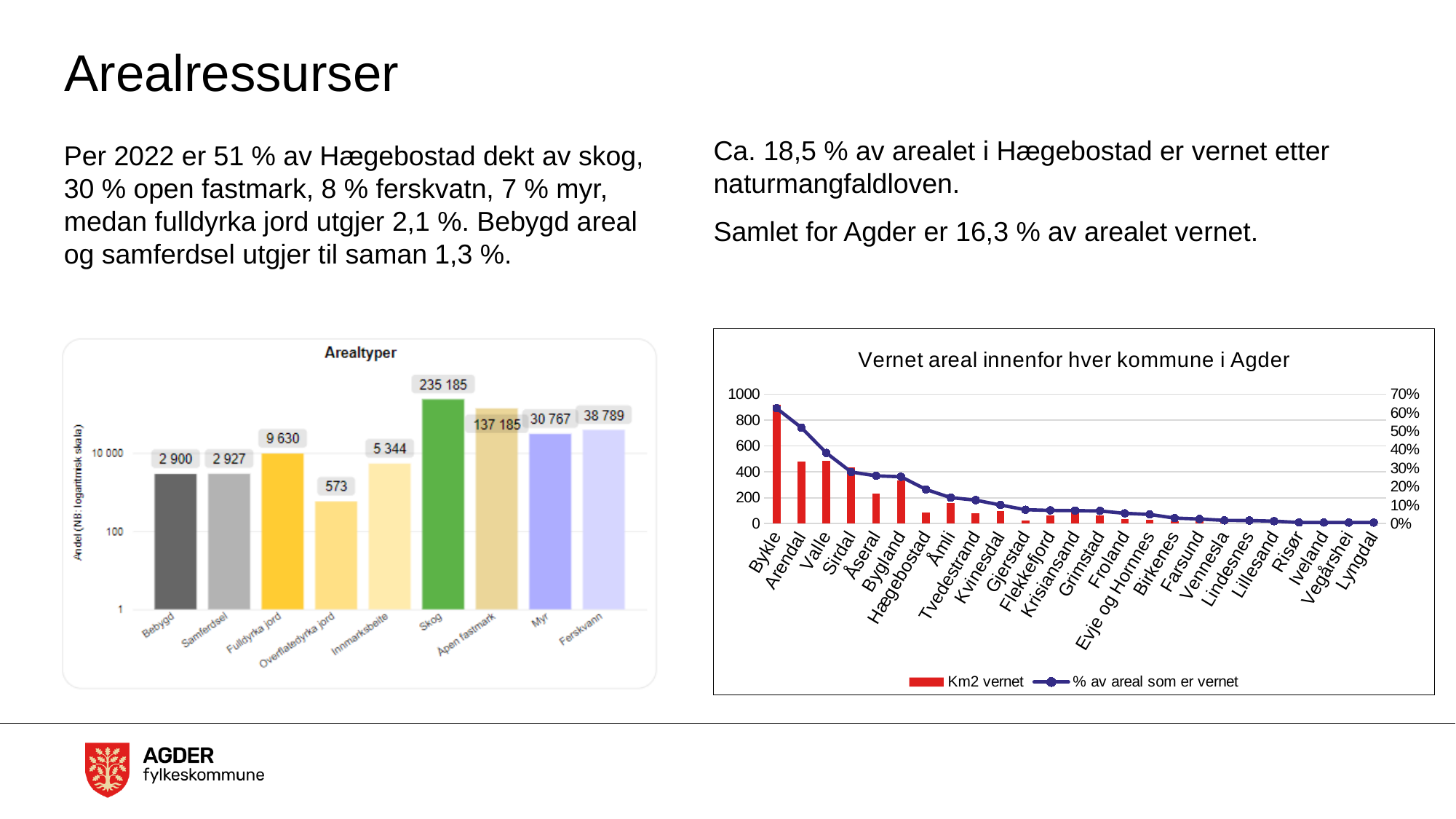
How many categories are shown in the Arealtyper chart? 9 In the chart 'Vernet areal innenfor hver kommune i Agder', is the Km2 vernet value for Arendal greater or less than 600? less In the Arealtyper chart, what is the value for Myr? 30 767 In the Arealtyper chart, what is the value for Skog? 235 185 In the Arealtyper chart, which category has the lowest value? Overflatedyrka jord How many municipalities are shown on the x axis of the chart 'Vernet areal innenfor hver kommune i Agder'? 25 In the chart 'Vernet areal innenfor hver kommune i Agder', which municipality has the highest Km2 vernet? Bykle In the Arealtyper chart, what is the value for Overflatedyrka jord? 573 How many series does the legend of the chart 'Vernet areal innenfor hver kommune i Agder' list? 2 In the Arealtyper chart, what is the difference between Ferskvann and Myr? 8 022 In the Arealtyper chart, which category has the highest value? Skog In the Arealtyper chart, which is larger, Fulldyrka jord or Innmarksbeite? Fulldyrka jord